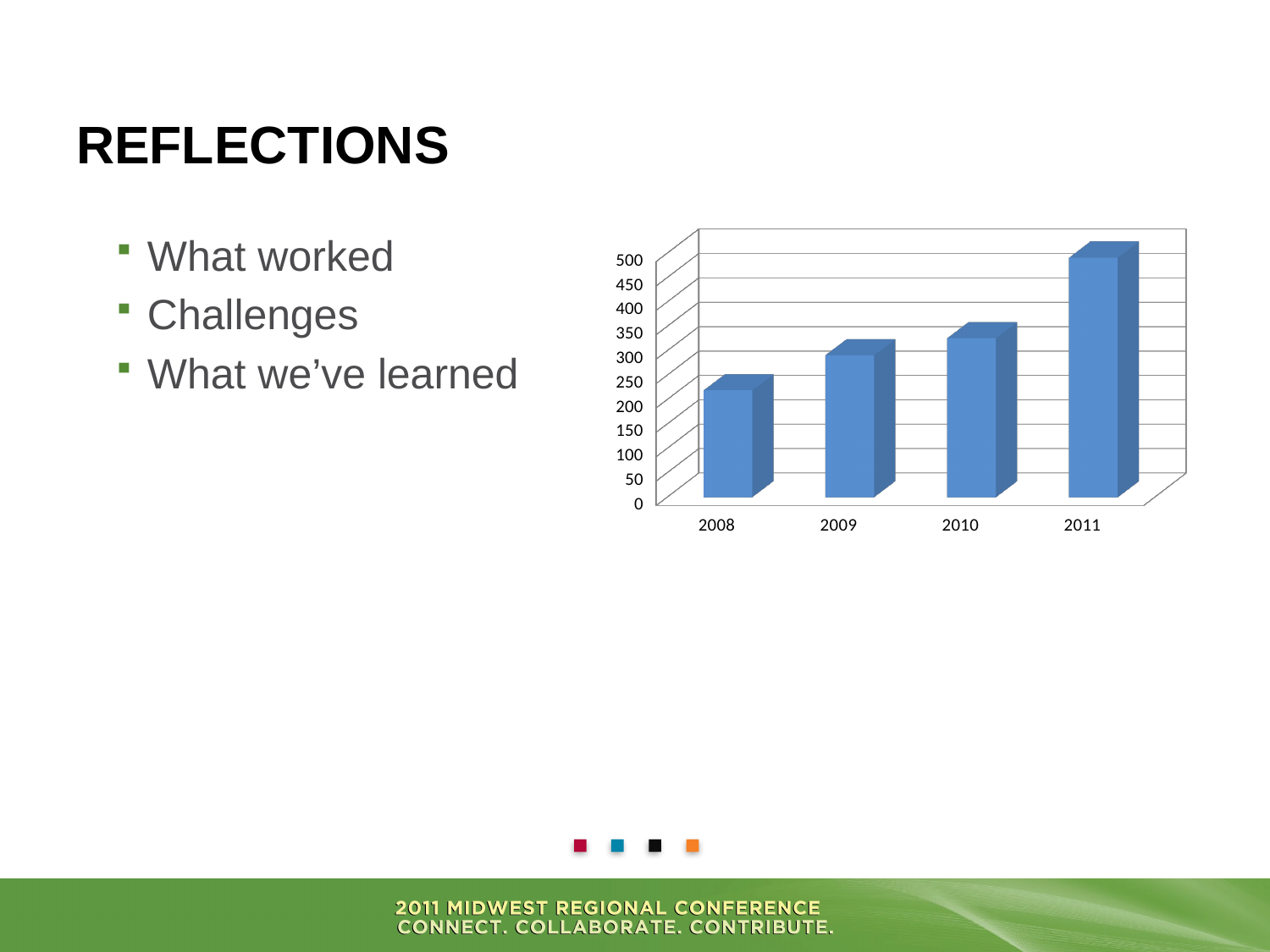
What kind of chart is shown on the slide? bar chart Which year has the larger value, 2009 or 2011? 2011 Which year has the lowest bar in the chart? 2008 Is the value for 2008 greater or less than 300? less How many years are shown on the x axis of the chart? 4 Is the value for 2011 greater or less than 400? greater Which year has the highest bar in the chart? 2011 Is the value for 2009 greater or less than 200? greater Do the values in the chart rise or fall from 2008 to 2011? rise Which year has the larger value, 2008 or 2011? 2011 What colour are the bars in the chart? blue